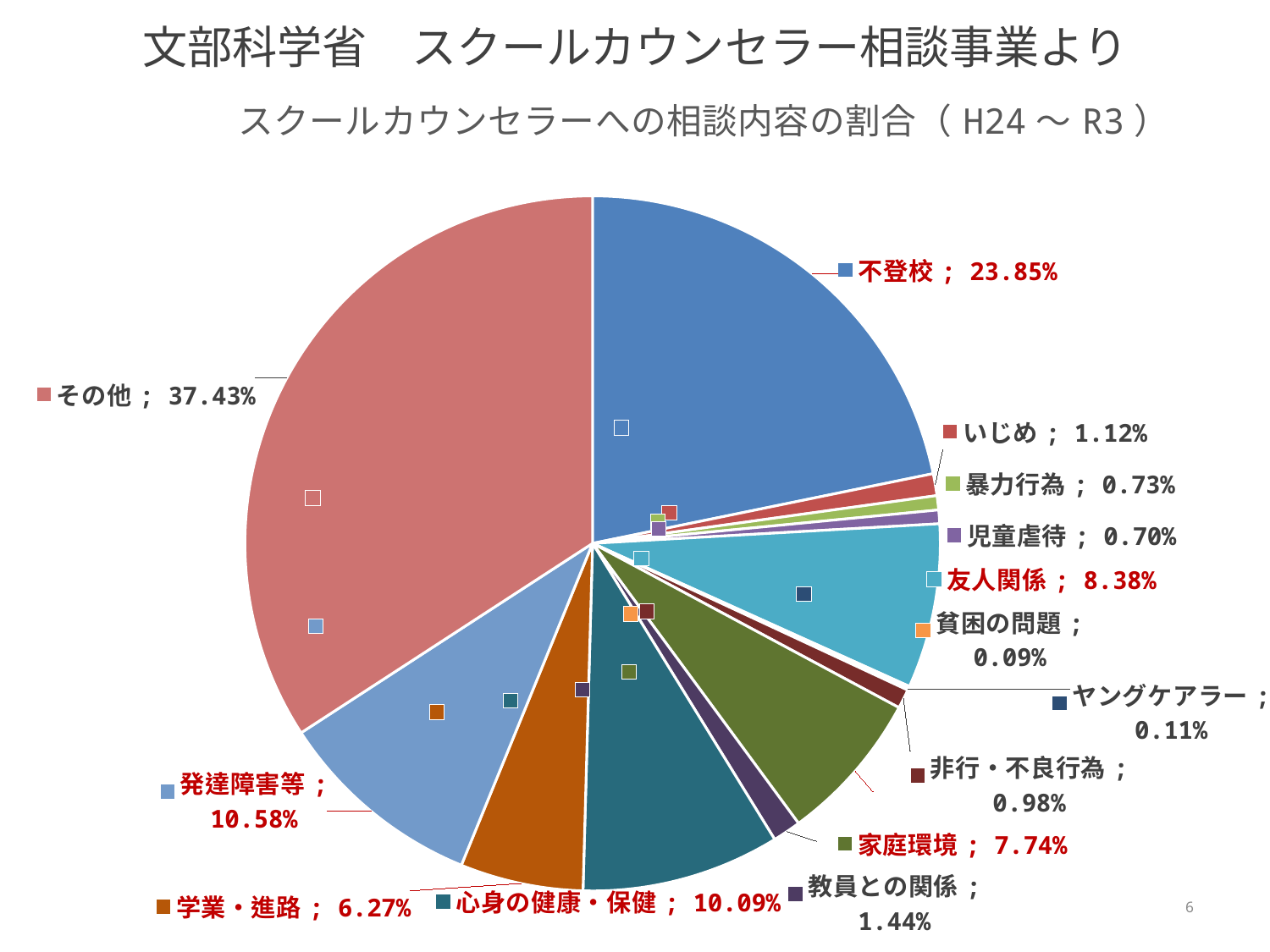
What kind of chart is shown on the slide? Pie chart What is the difference in percentage points between 不登校 and 発達障害等? 13.27 What is the percentage for 友人関係? 8.38% What is the percentage for 貧困の問題? 0.09% Which is larger, 家庭環境 or 学業・進路? 家庭環境 What is the percentage for 心身の健康・保健? 10.09% What is the difference in percentage points between その他 and 不登校? 13.58 How many categories are shown in the pie chart? 14 What is the title of the chart? スクールカウンセラーへの相談内容の割合（H24～R3） What is the percentage for 不登校? 23.85% Which category has the largest share of the pie? その他 Which category has the smallest share of the pie? 貧困の問題